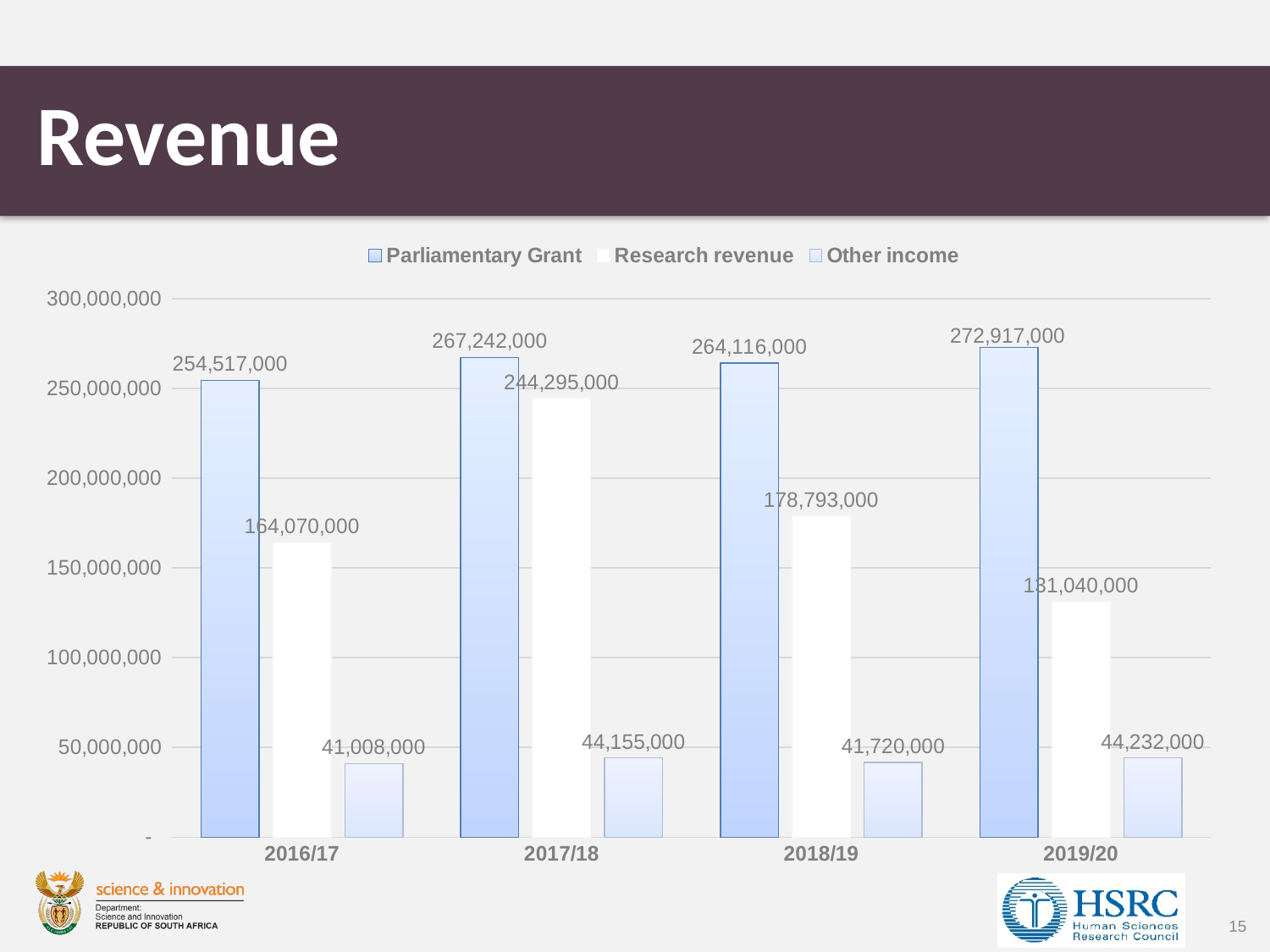
What is the Research revenue value for 2017/18? 244,295,000 In which year is the Parliamentary Grant highest? 2019/20 In which year is Research revenue highest? 2017/18 How many series does the legend list? 3 Which is larger in 2018/19, the Parliamentary Grant or Research revenue? Parliamentary Grant Is the Research revenue value for 2016/17 greater or less than 150,000,000? greater In which year is Research revenue lowest? 2019/20 What is the Parliamentary Grant value for 2016/17? 254,517,000 What kind of chart is shown on the slide? bar chart What is the difference between the Parliamentary Grant in 2019/20 and in 2016/17? 18,400,000 How many years are shown on the x axis? 4 What is the Other income value for 2018/19? 41,720,000